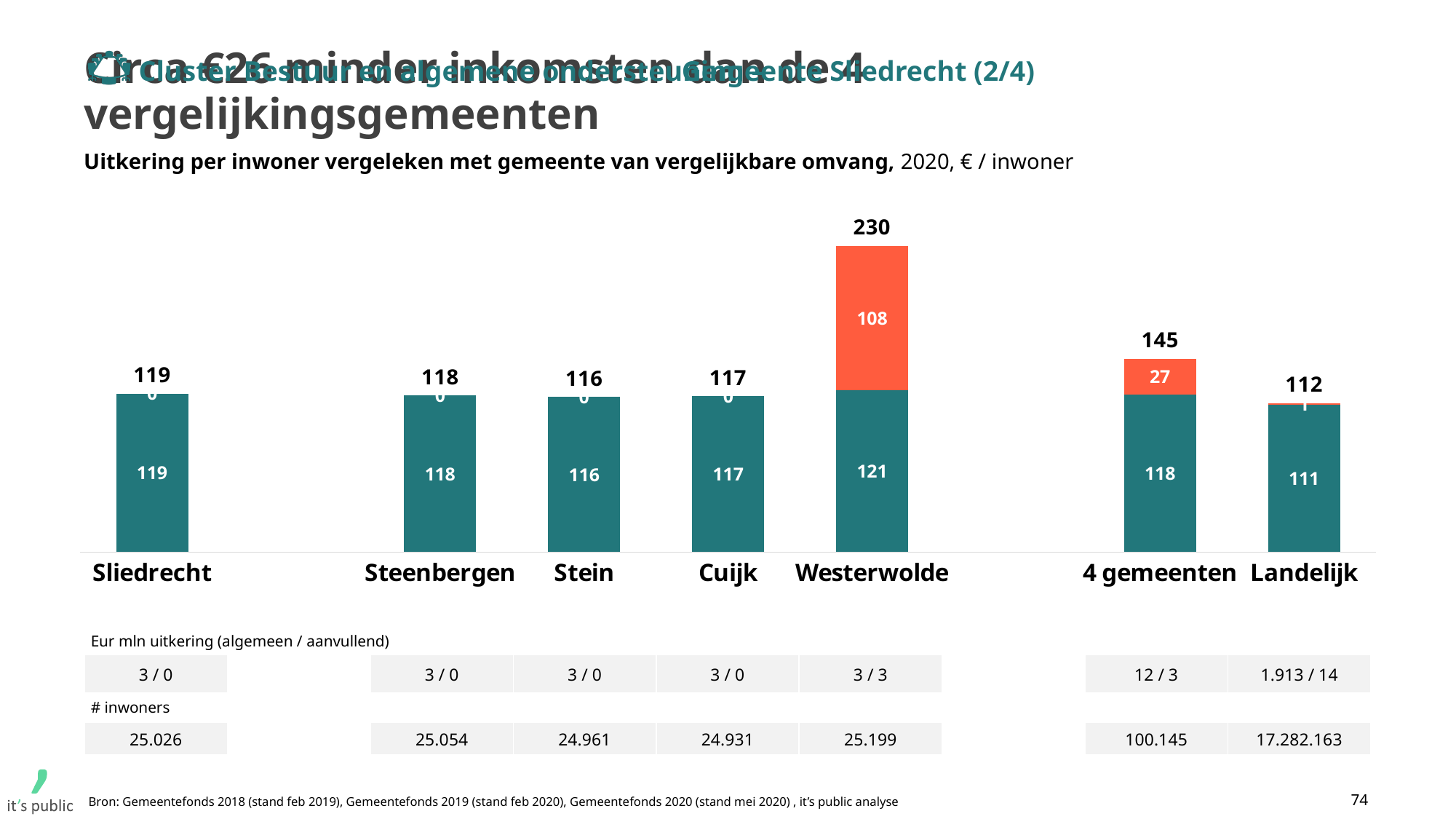
Which category has the highest total value? Westerwolde What is the total value shown above the bar for Sliedrecht? 119 What is the value of the teal (bottom) segment of the 4 gemeenten bar? 118 What is the difference between the total for Westerwolde and the total for Sliedrecht? 111 Which category has the lowest total value? Landelijk How many categories are shown on the x axis of the chart? 7 What is the difference between the total for 4 gemeenten and the total for Landelijk? 33 What is the value of the orange (top) segment of the Westerwolde bar? 108 What kind of chart is shown on the slide? Stacked bar chart What is the value of the orange (top) segment of the 4 gemeenten bar? 27 Which has a larger total value, Westerwolde or 4 gemeenten? Westerwolde What is the total value shown above the bar for Westerwolde? 230